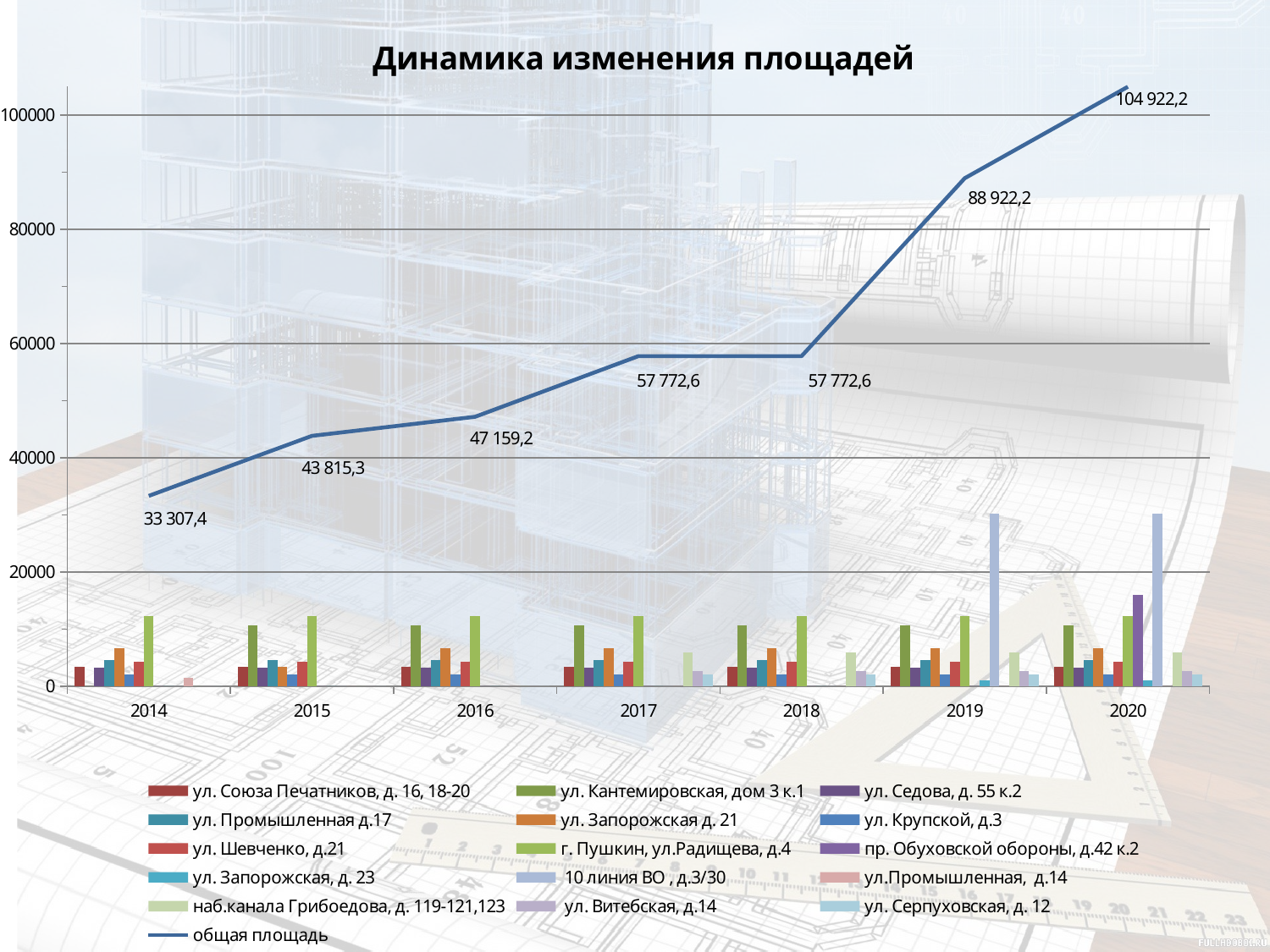
Is the value of общая площадь in 2019 greater or less than 80000? greater What is the difference in общая площадь between 2015 and 2014? 10 507,9 How many series does the legend list? 16 Are the values of общая площадь for 2017 and 2018 the same or different? the same What is the value of общая площадь in 2020? 104 922,2 In which year is общая площадь highest? 2020 How many years are shown on the x axis? 7 By how much did общая площадь increase from 2019 to 2020? 16 000,0 Is the bar for 10 линия ВО, д.3/30 in 2019 greater or less than 20000? greater What is the value of общая площадь in 2017? 57 772,6 What is the value of общая площадь in 2014? 33 307,4 In which year is общая площадь lowest? 2014